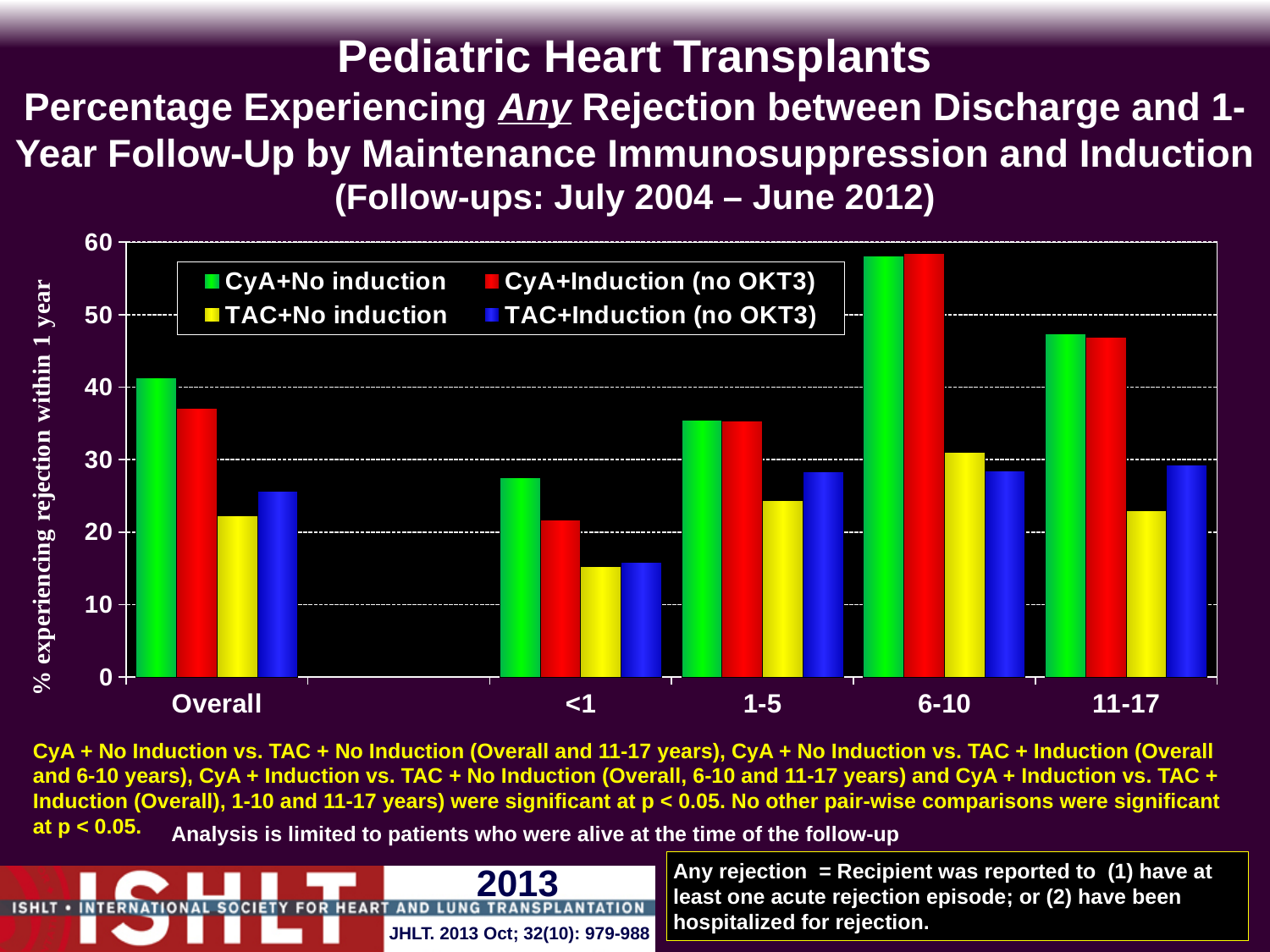
How many series does the legend list? 4 For the CyA+No induction series, which category has the highest value? 6-10 Is the value for CyA+Induction (no OKT3) in the 6-10 category greater or less than 50? greater For the TAC+No induction series, which category has the lowest value? <1 In the Overall category, which is larger: CyA+No induction or TAC+No induction? CyA+No induction For the TAC+Induction (no OKT3) series, which category has the lowest value? <1 What kind of chart is shown on the slide? bar chart Is the value for CyA+No induction in the Overall category greater or less than 30? greater How many age categories are shown on the x axis? 4 Which colour represents TAC+Induction (no OKT3) in the legend? blue Is the value for TAC+No induction in the <1 category greater or less than 20? less For the CyA+No induction series, which category has the lowest value? <1